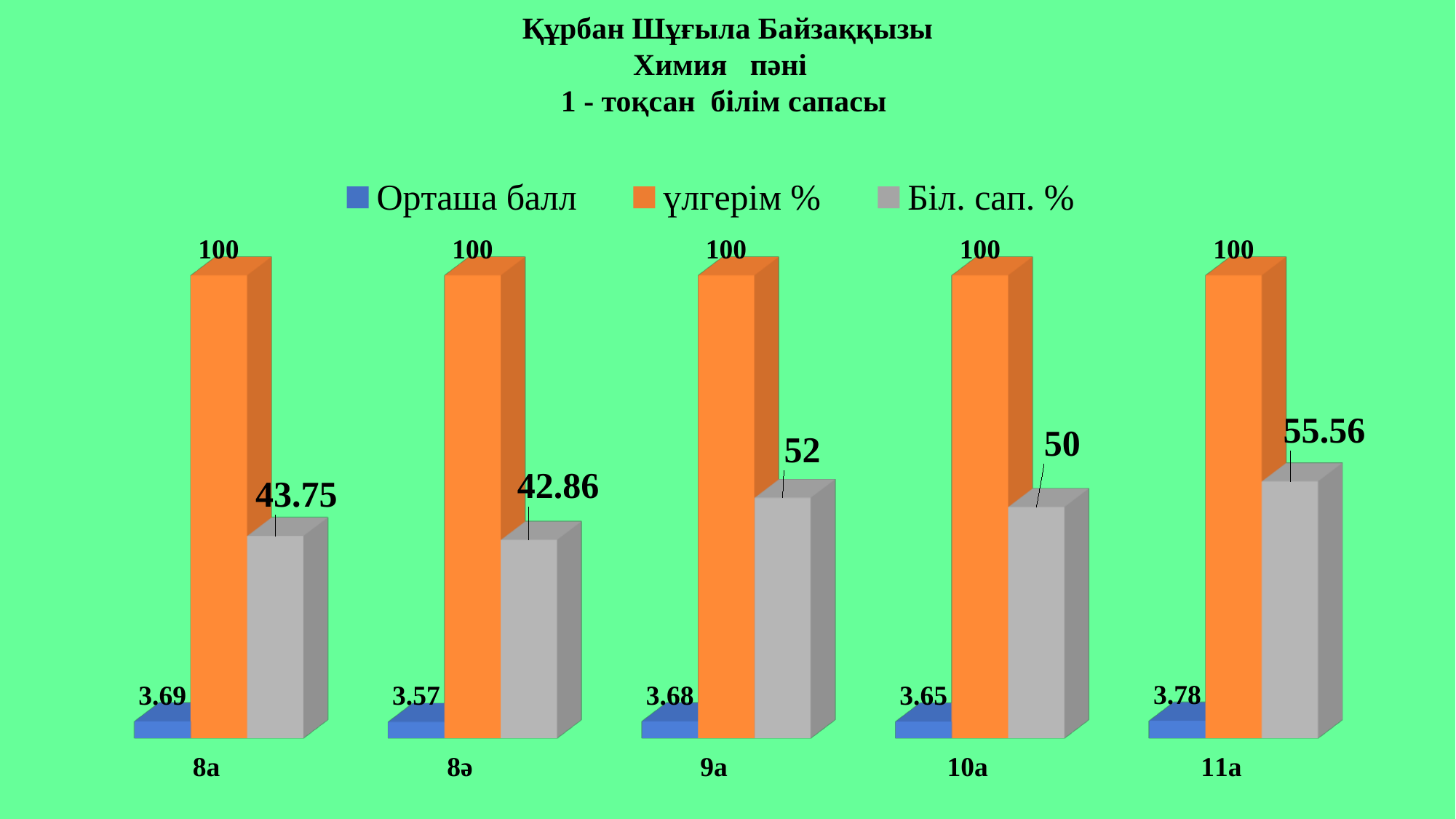
Which colour represents the үлгерім % series in the legend? orange Which is larger, the Біл. сап. % value for 8а or for 8ә? 8а What is the value of Біл. сап. % for class 11а? 55.56 What is the difference between the Біл. сап. % values for 9а and 10а? 2 How many series does the legend list? 3 Which class has the highest Біл. сап. % value? 11а What is the Орташа балл value for class 8ә? 3.57 What is the үлгерім % value for class 9а? 100 Which class has the lowest Орташа балл value? 8ә What is the difference between the Орташа балл values for 11а and 10а? 0.13 How many classes are shown on the x axis? 5 What kind of chart is shown on the slide? bar chart